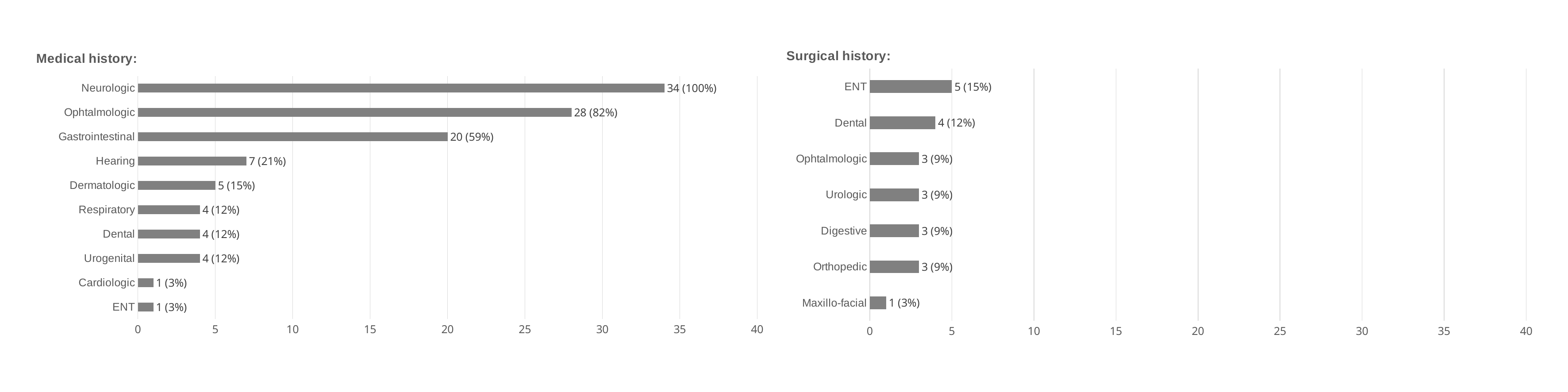
In the 'Medical history' chart, what is the value for Gastrointestinal? 20 (59%) How many categories are shown in the 'Medical history' chart? 10 In the 'Surgical history' chart, what is the value for Dental? 4 (12%) In the 'Medical history' chart, what is the value for Hearing? 7 (21%) In the 'Surgical history' chart, which is larger, the value for ENT or the value for Ophtalmologic? ENT How many categories are shown in the 'Surgical history' chart? 7 In the 'Medical history' chart, what is the difference between the counts for Neurologic and Ophtalmologic? 6 What kind of chart is the 'Surgical history' chart? Bar chart In the 'Medical history' chart, is the value for Hearing greater or less than 10? less In the 'Medical history' chart, which category has the highest value? Neurologic In the 'Surgical history' chart, which category has the lowest value? Maxillo-facial What is the title of the chart on the right side of the slide? Surgical history: